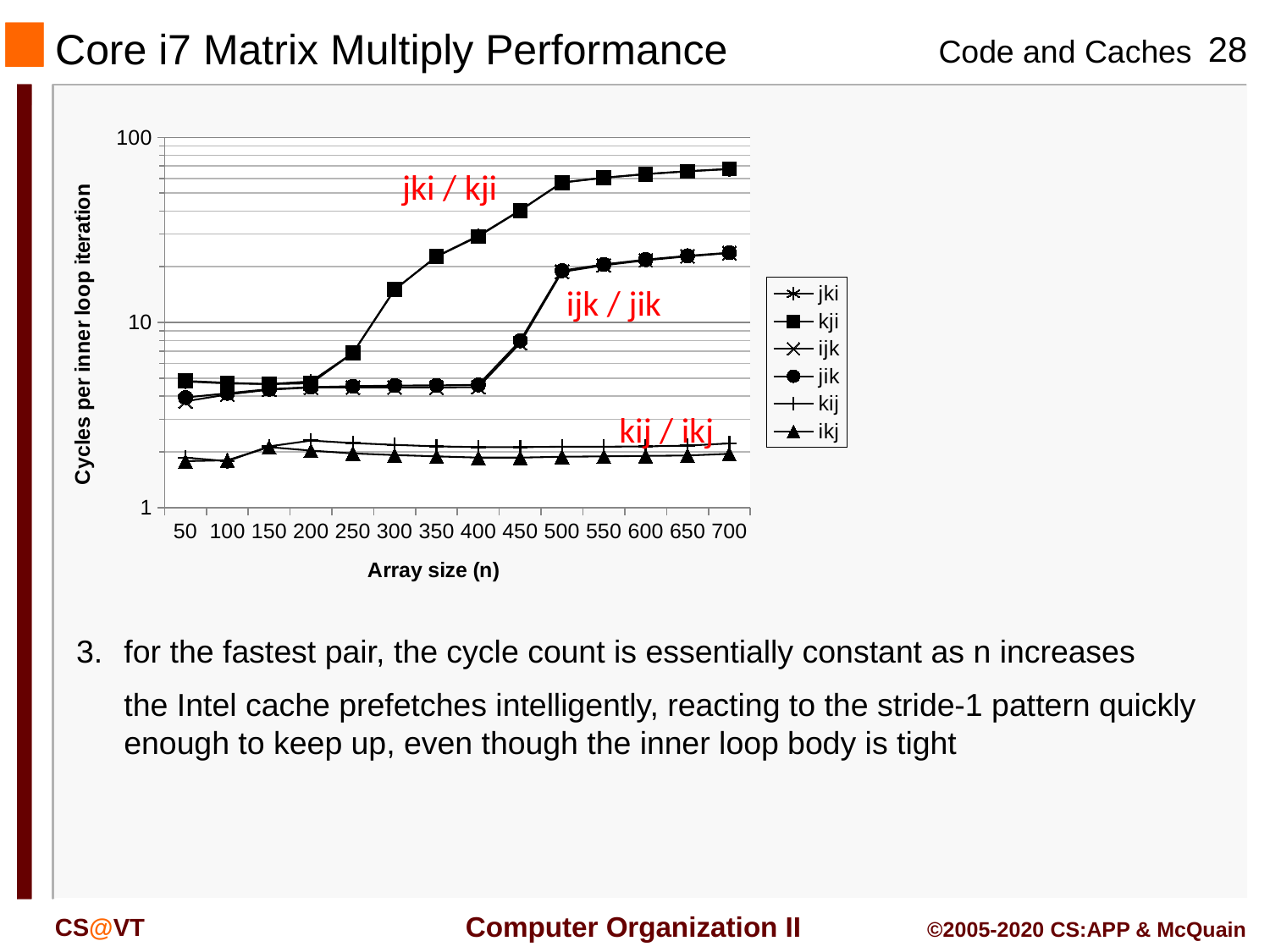
Is the value for kji at array size 50 greater or less than 10? less Is the value for ikj at array size 700 greater or less than 10? less What kind of chart is shown on the slide? line chart At array size 700, which is larger, the value for kji or the value for ikj? kji What is the title of the x axis? Array size (n) Is the value for kji at array size 700 greater or less than 10? greater How many series does the legend list? 6 How many array sizes are plotted along the x axis? 14 Do the values for kji rise or fall as the array size increases? rise What is the title of the y axis? Cycles per inner loop iteration